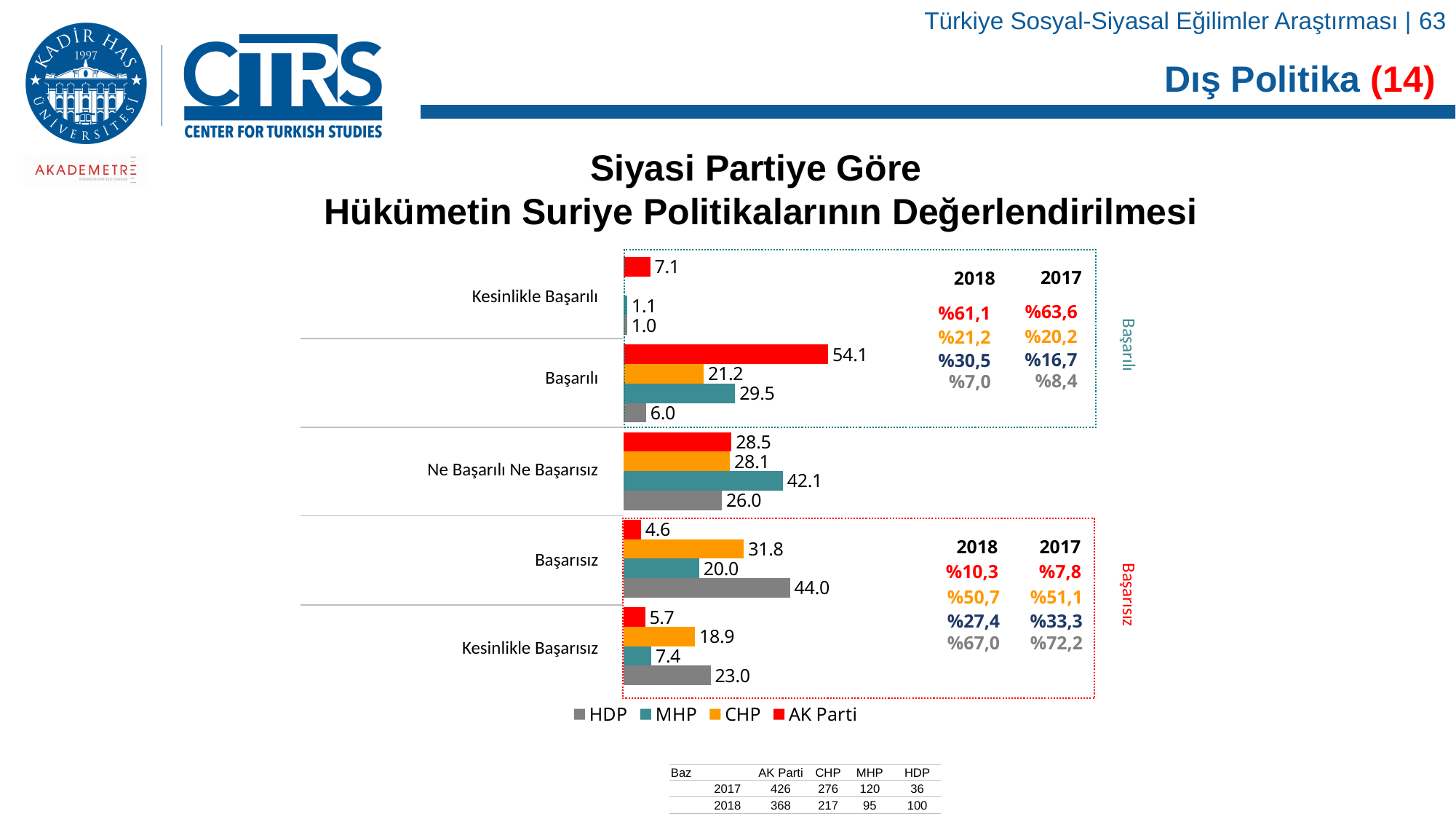
How many series does the legend list? 4 What is the difference between the CHP and MHP values in the Başarısız category? 11.8 What is the value for HDP in the Başarısız category? 44.0 What is the value for MHP in the Ne Başarılı Ne Başarısız category? 42.1 Which party has the lowest value in the Başarısız category? AK Parti In the Kesinlikle Başarısız category, which is larger: the HDP value or the MHP value? HDP How many categories are shown on the chart? 5 What is the value for CHP in the Kesinlikle Başarısız category? 18.9 Which legend entry is shown in red? AK Parti What type of chart is shown on the slide? bar chart What is the value for AK Parti in the Başarılı category? 54.1 Which party has the highest value in the Başarılı category? AK Parti